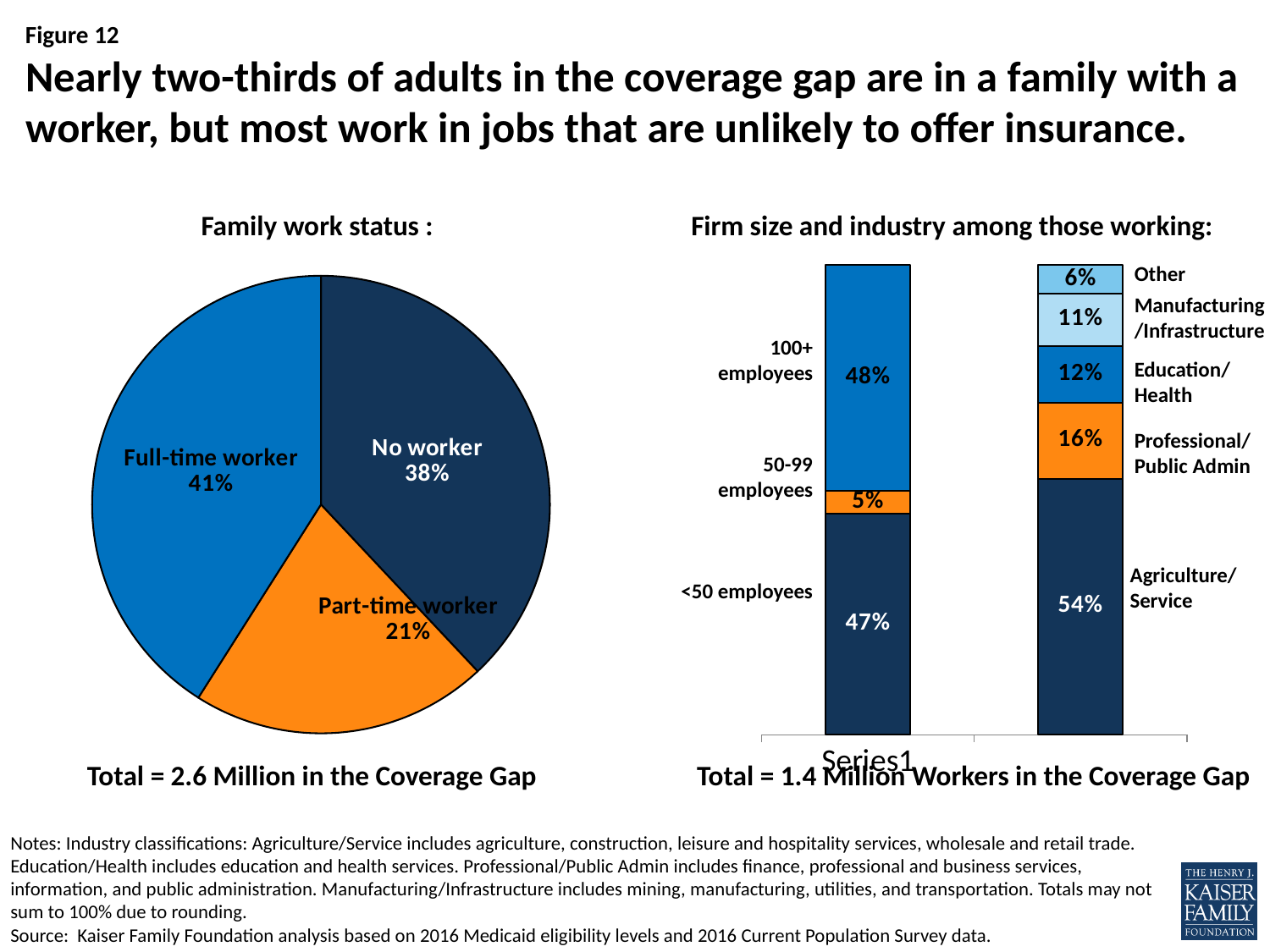
In the Firm size and industry chart, what percentage of workers are at firms with 100+ employees? 48% What type of chart is the Firm size and industry chart on the right? Stacked bar chart In the Firm size and industry chart, what is the difference in percentage points between Manufacturing/Infrastructure and Other? 5 In the Family work status pie chart, which category has the smallest share? Part-time worker In the Family work status pie chart, what is the difference in percentage points between No worker and Part-time worker? 17 In the Family work status pie chart, what percentage is labelled for Part-time worker? 21% In the Firm size and industry chart, which is larger: the share in Education/Health or the share in Professional/Public Admin? Professional/Public Admin In the Firm size and industry chart, which firm size category has the smallest share? 50-99 employees In the Family work status pie chart, what share of adults in the coverage gap are in a family with a full-time worker? 41% In the Family work status pie chart, which category has the largest share? Full-time worker In the Firm size and industry chart, what percentage of workers are in Agriculture/Service? 54% In the Family work status pie chart, how many slices are there? 3